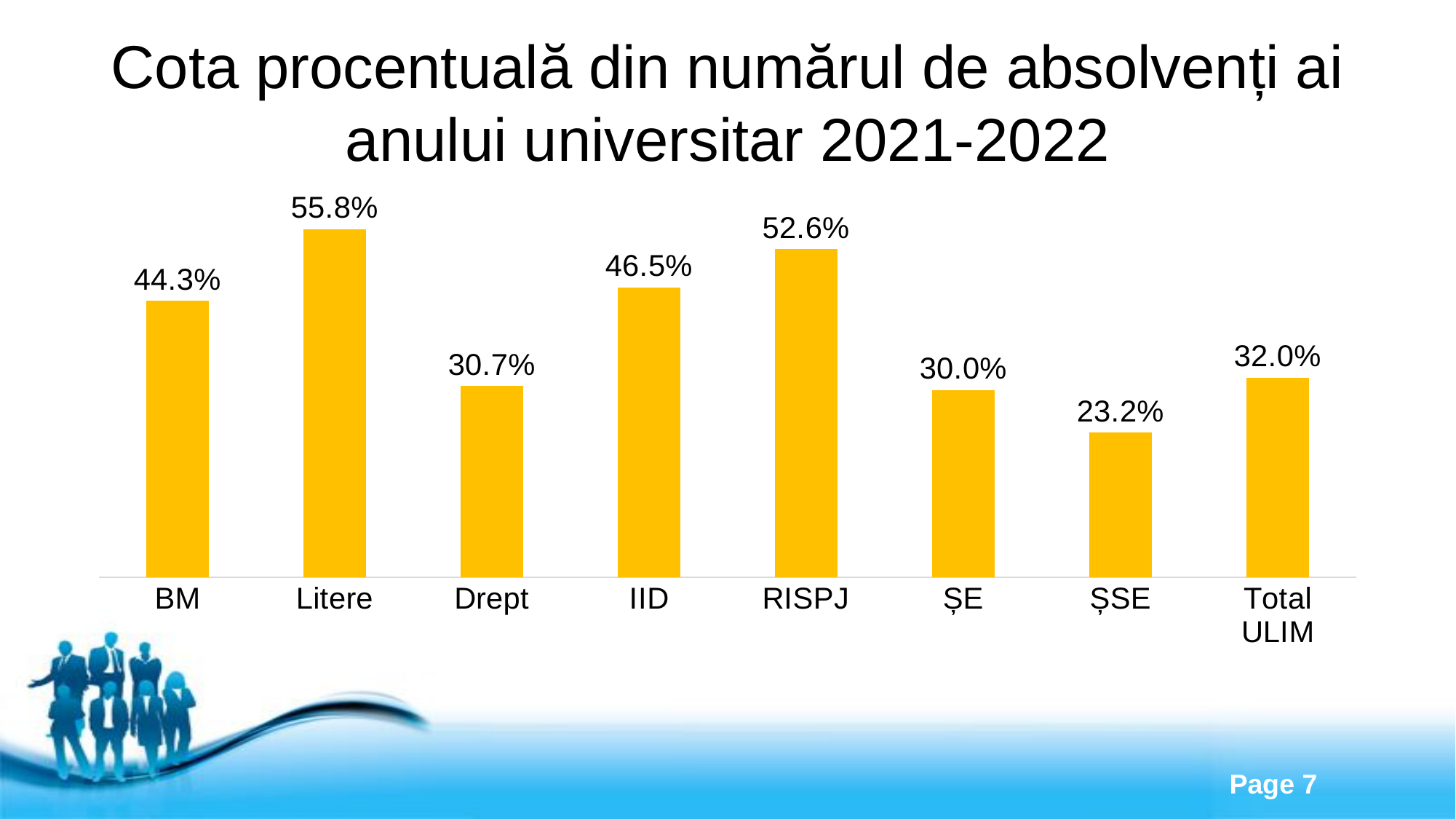
What is the value for Total ULIM? 32.0% What kind of chart is shown on the slide? Bar chart What is the difference between the values for IID and Drept? 15.8% Which is larger, the value for BM or the value for IID? IID What is the value for ȘSE? 23.2% What is the value for Litere? 55.8% What is the title of the chart on the slide? Cota procentuală din numărul de absolvenți ai anului universitar 2021-2022 What is the value for RISPJ? 52.6% Which category has the lowest value? ȘSE How many categories are shown on the x axis? 8 Which category has the highest value? Litere What is the difference between the values for Litere and BM? 11.5%